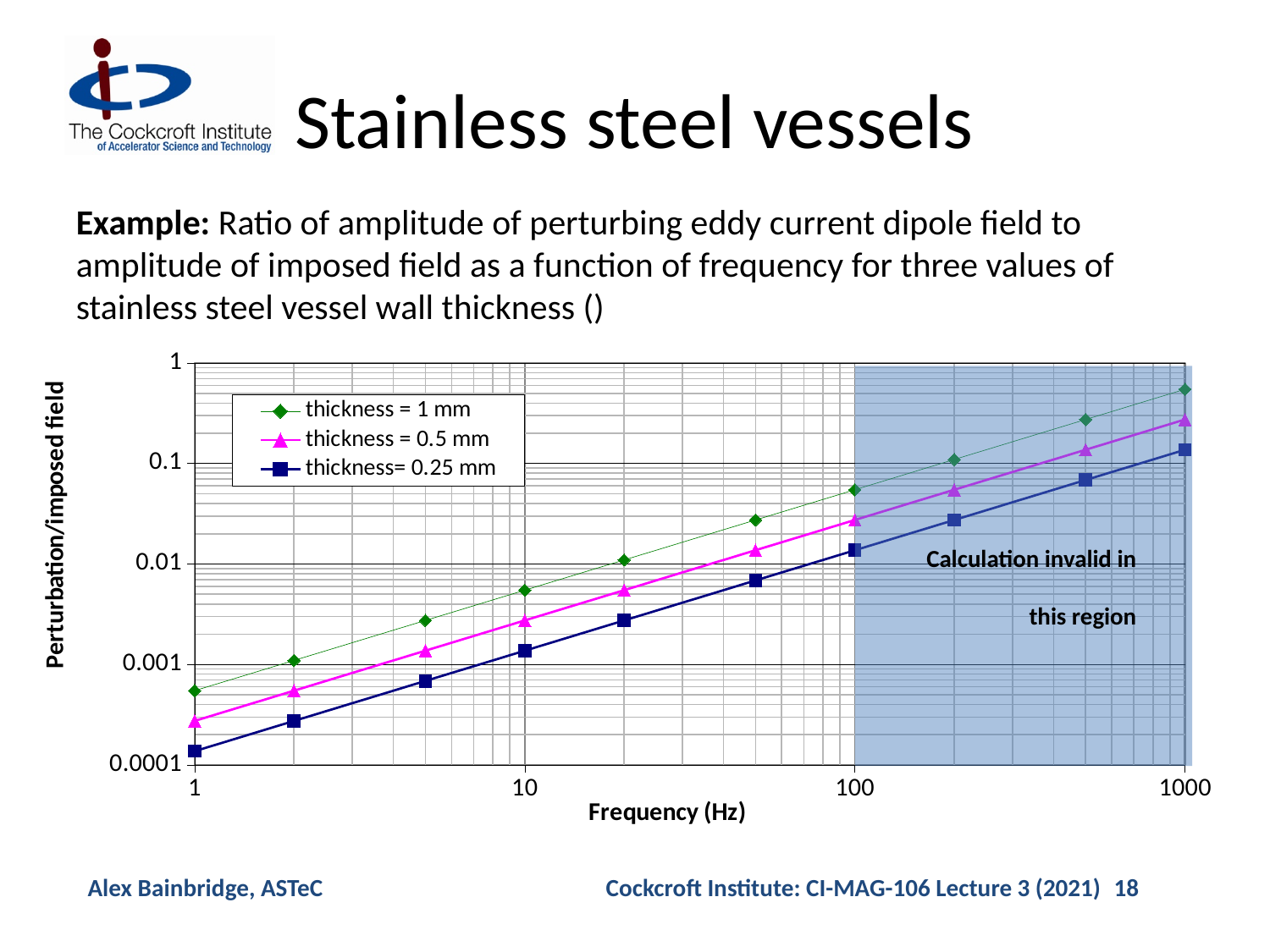
Is the value for thickness = 0.5 mm at 100 Hz greater or less than 0.01? greater What is the label of the x axis of the chart? Frequency (Hz) Is the value for thickness = 1 mm at 1000 Hz greater or less than 0.1? greater Do the values for thickness = 1 mm rise or fall as frequency increases? Rise Is the value for thickness= 0.25 mm at 1 Hz greater or less than 0.001? less What text is written in the shaded region of the chart? Calculation invalid in this region How many series does the chart legend list? 3 Which series has the lowest perturbation/imposed field values across the frequency range? thickness= 0.25 mm What kind of chart is shown on the slide? Line chart At 100 Hz, which is larger: the value for thickness = 1 mm or the value for thickness= 0.25 mm? thickness = 1 mm Which series has the highest perturbation/imposed field values across the frequency range? thickness = 1 mm